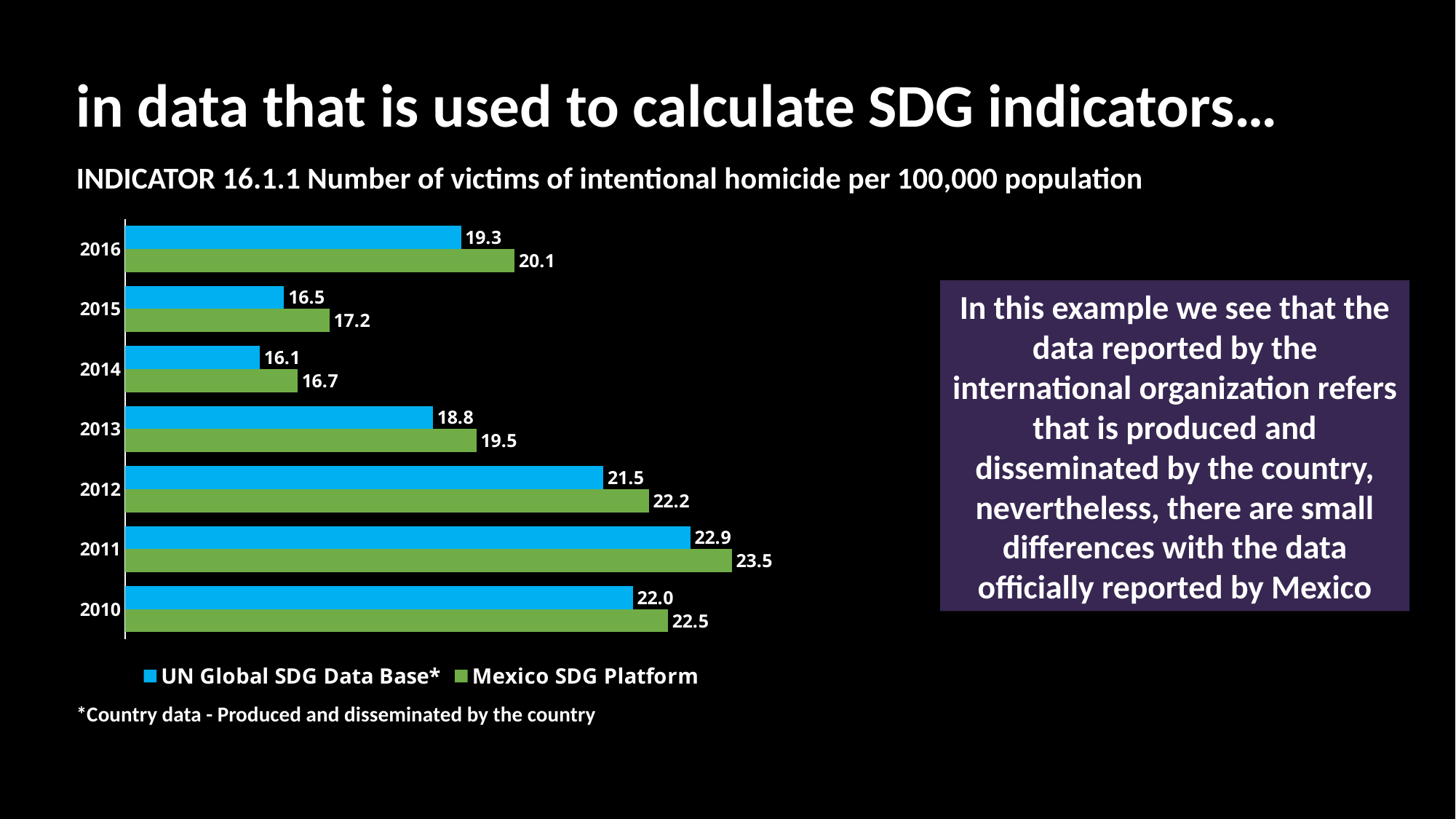
What kind of chart is shown on the slide? Bar chart Which colour represents the Mexico SDG Platform series? Green How many years are shown on the chart? 7 What is the difference between the Mexico SDG Platform value and the UN Global SDG Data Base* value in 2011? 0.6 Which year has the lowest value for the UN Global SDG Data Base* series? 2014 How many series does the legend list? 2 What is the value for the Mexico SDG Platform series in 2013? 19.5 Which is larger in 2015: the UN Global SDG Data Base* value or the Mexico SDG Platform value? Mexico SDG Platform Which year has the highest value for the Mexico SDG Platform series? 2011 What is the value for the UN Global SDG Data Base* series in 2016? 19.3 What is the value for the UN Global SDG Data Base* series in 2010? 22.0 Does the UN Global SDG Data Base* value rise or fall from 2010 to 2014? Fall